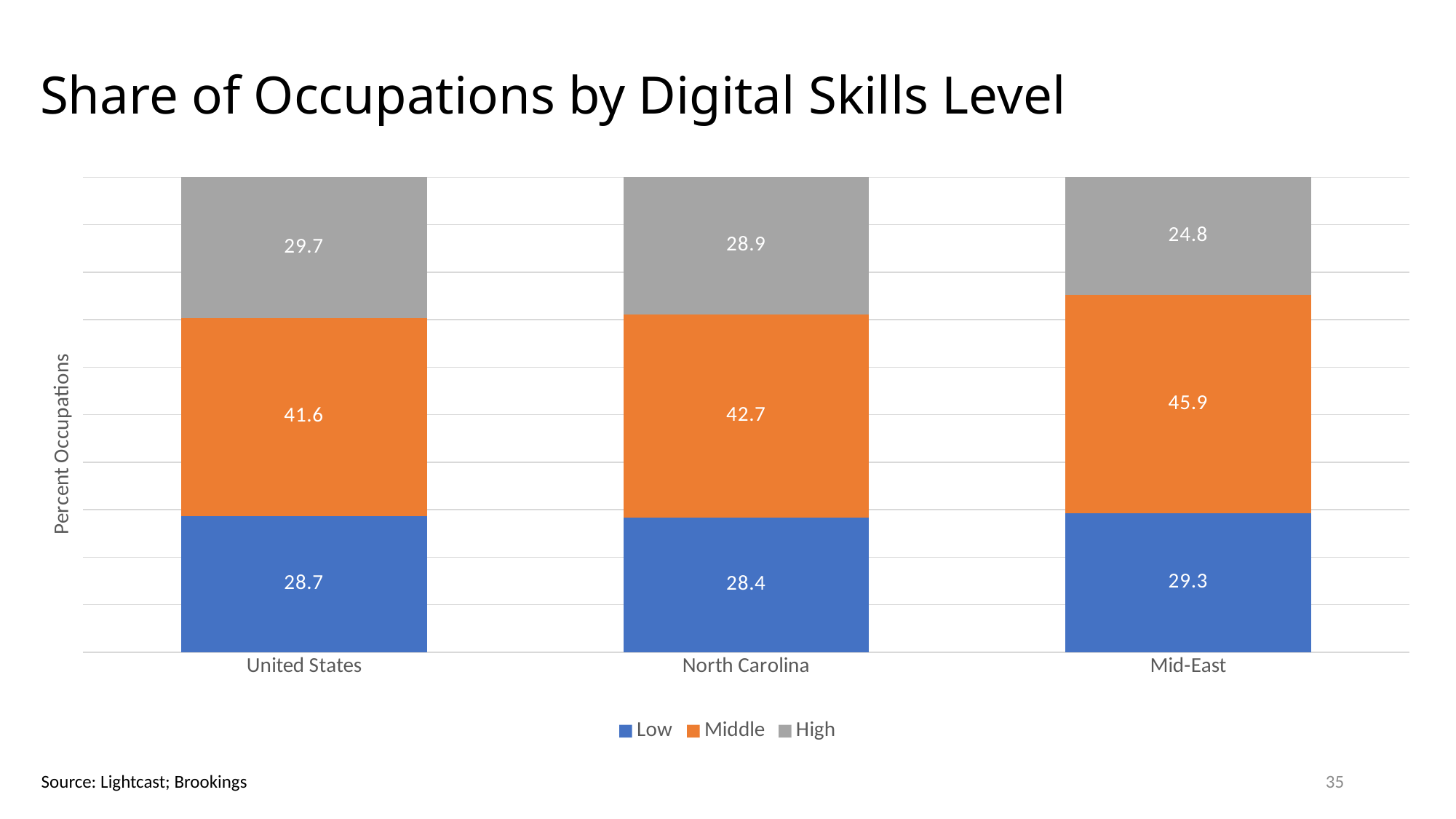
Which category has the highest value for the Middle series? Mid-East What is the value for the Middle series for Mid-East? 45.9 What kind of chart is shown on the slide? Stacked bar chart What is the value for the Low series for North Carolina? 28.4 What is the title of the chart? Share of Occupations by Digital Skills Level How many series does the legend list? 3 Which category has the lowest value for the High series? Mid-East What is the value for the High series for United States? 29.7 What is the total of the stacked bar for North Carolina? 100.0 How many categories are shown on the x axis? 3 What is the difference between the Middle values for Mid-East and United States? 4.3 Which is larger, the High value for North Carolina or the High value for Mid-East? North Carolina